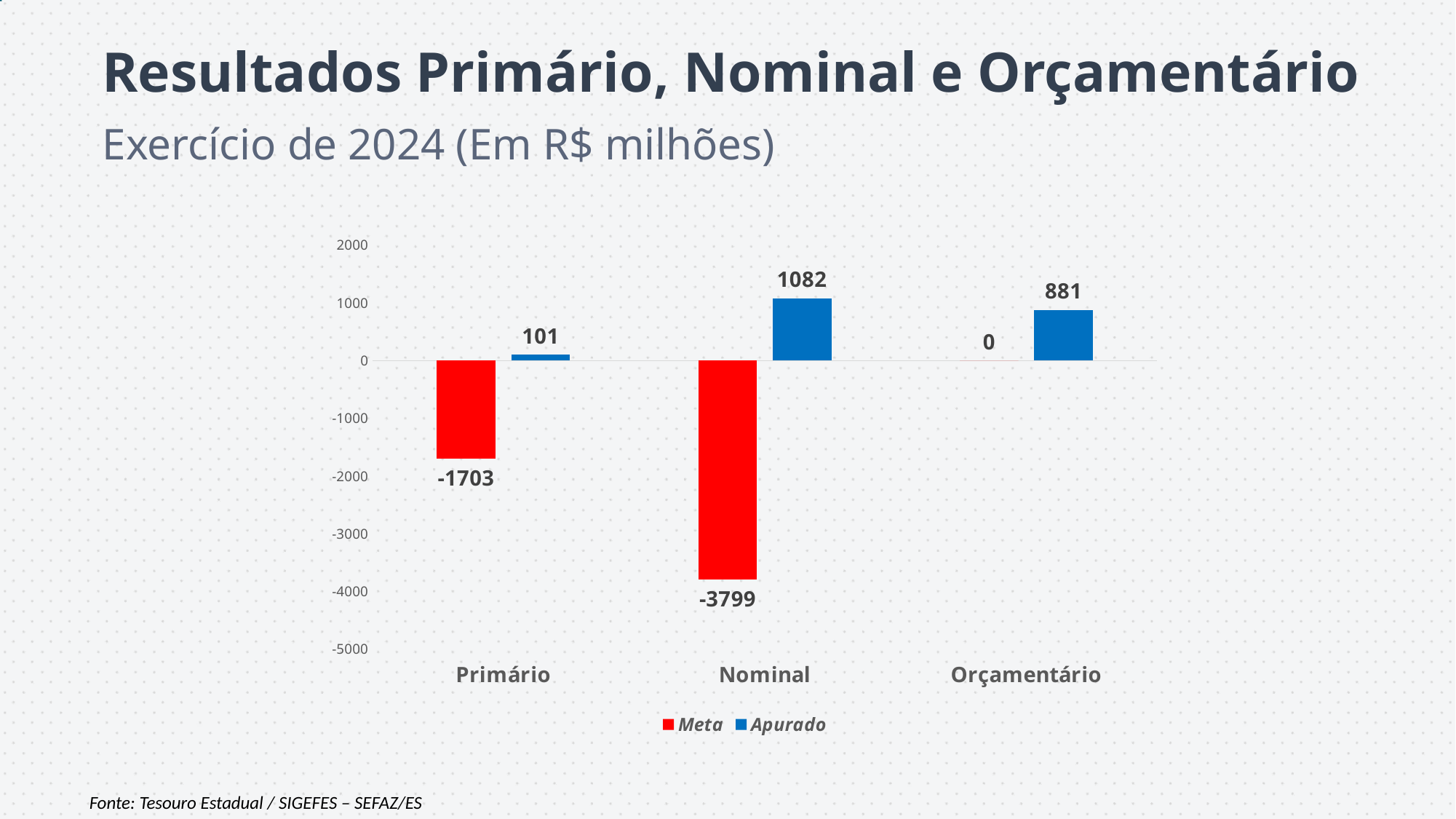
Which category has the lowest Meta value? Nominal Which category has the highest Apurado value? Nominal What is the Apurado value for Nominal? 1082 What is the difference between the Apurado and Meta values for Nominal? 4881 What is the Meta value for Primário? -1703 How many categories are shown on the x axis? 3 What kind of chart is shown on the slide? Bar chart How many series does the legend list? 2 What is the Apurado value for Orçamentário? 881 Which colour represents the Meta series in the legend? Red What is the Meta value for Orçamentário? 0 Which is larger, the Apurado value for Primário or the Apurado value for Orçamentário? Orçamentário